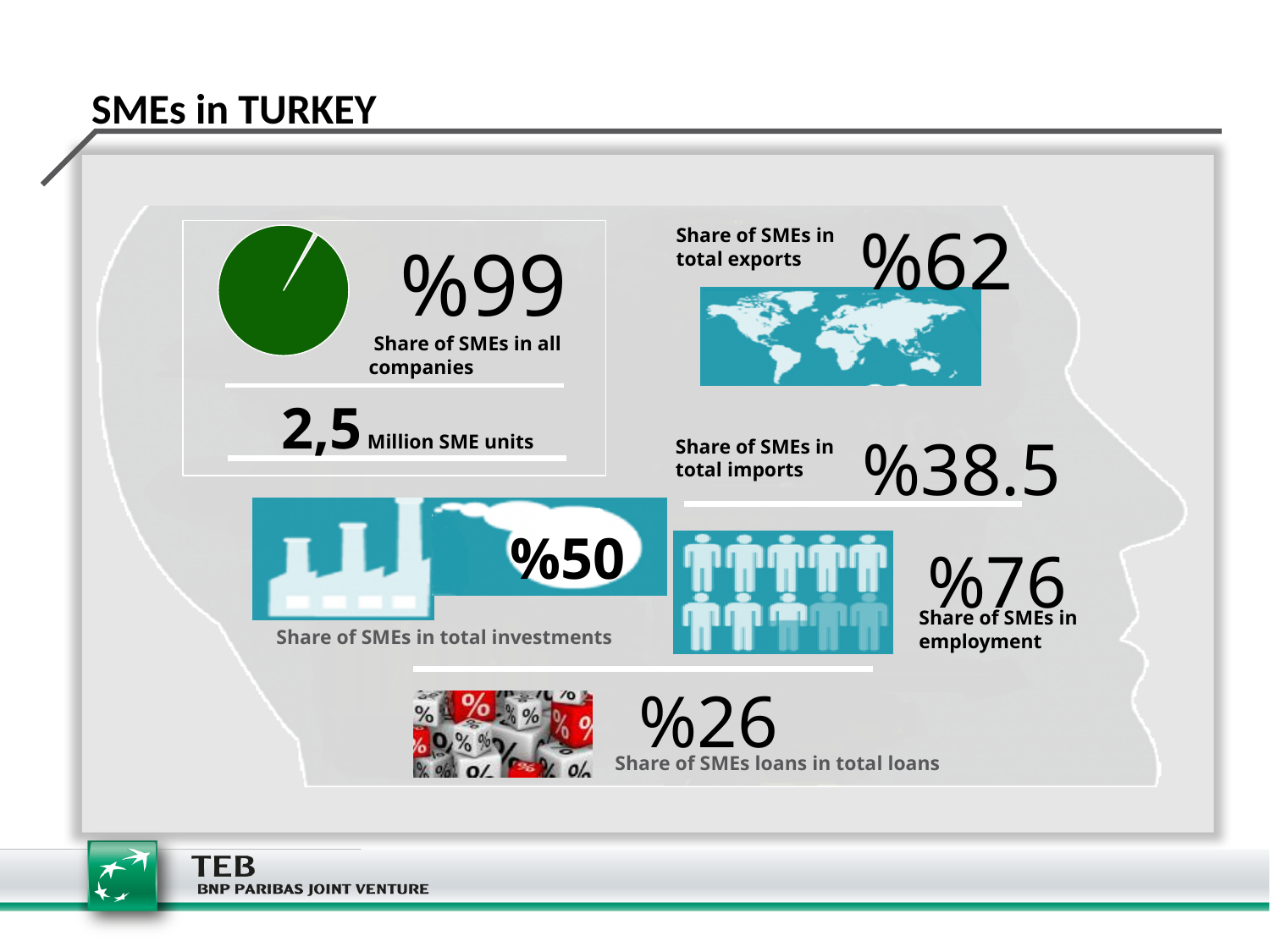
What is the title of the slide containing the pie chart? SMEs in TURKEY How many slices does the pie chart for the share of SMEs in all companies have? 2 How many million SME units are reported below the pie chart? 2,5 What kind of chart is shown next to the label 'Share of SMEs in all companies'? pie chart What colour is the large slice of the pie chart showing the share of SMEs in all companies? green In the pie chart, is the share of SMEs in all companies greater or less than 50%? greater What share of all companies do SMEs represent according to the pie chart? %99